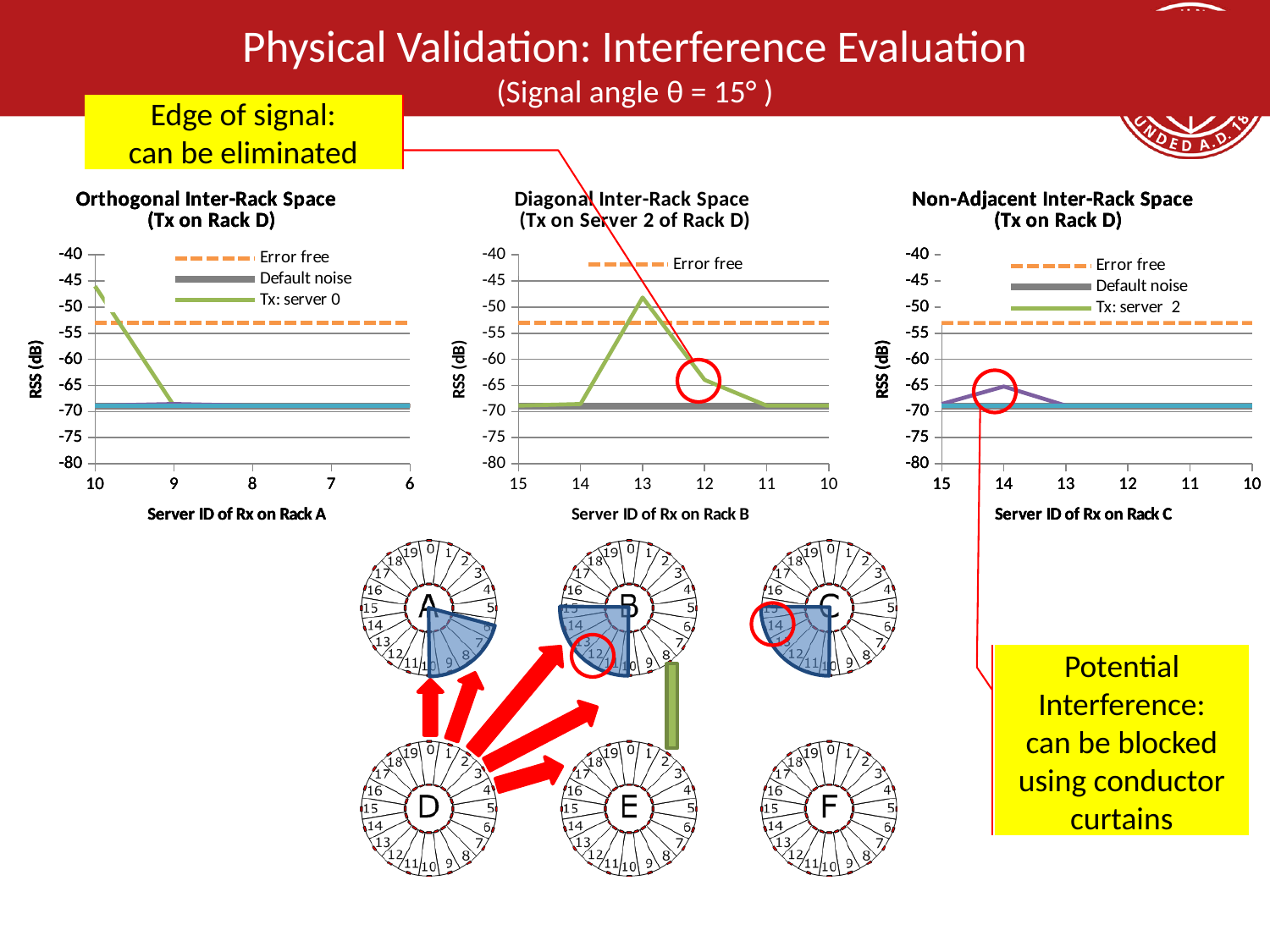
In the 'Diagonal Inter-Rack Space (Tx on Server 2 of Rack D)' chart, is the RSS of the green Tx line at server ID 13 greater or less than -55? greater In the 'Non-Adjacent Inter-Rack Space (Tx on Rack D)' chart, is the RSS of the Tx: server 2 line at server ID 14 greater or less than -60? less What type of chart is the 'Orthogonal Inter-Rack Space (Tx on Rack D)' chart? Line chart How many series does the legend of the 'Non-Adjacent Inter-Rack Space (Tx on Rack D)' chart list? 3 In the 'Orthogonal Inter-Rack Space (Tx on Rack D)' chart, does the Tx: server 0 line rise or fall from server ID 10 to server ID 9? fall How many series does the legend of the 'Orthogonal Inter-Rack Space (Tx on Rack D)' chart list? 3 What is the x-axis title of the 'Non-Adjacent Inter-Rack Space (Tx on Rack D)' chart? Server ID of Rx on Rack C In the 'Diagonal Inter-Rack Space (Tx on Server 2 of Rack D)' chart, at which server ID does the green Tx line reach its highest RSS? 13 How many server ID ticks are shown on the x axis of the 'Orthogonal Inter-Rack Space (Tx on Rack D)' chart? 5 How many server ID ticks are shown on the x axis of the 'Diagonal Inter-Rack Space (Tx on Server 2 of Rack D)' chart? 6 In the 'Orthogonal Inter-Rack Space (Tx on Rack D)' chart, at which server ID does the Tx: server 0 line reach its highest RSS? 10